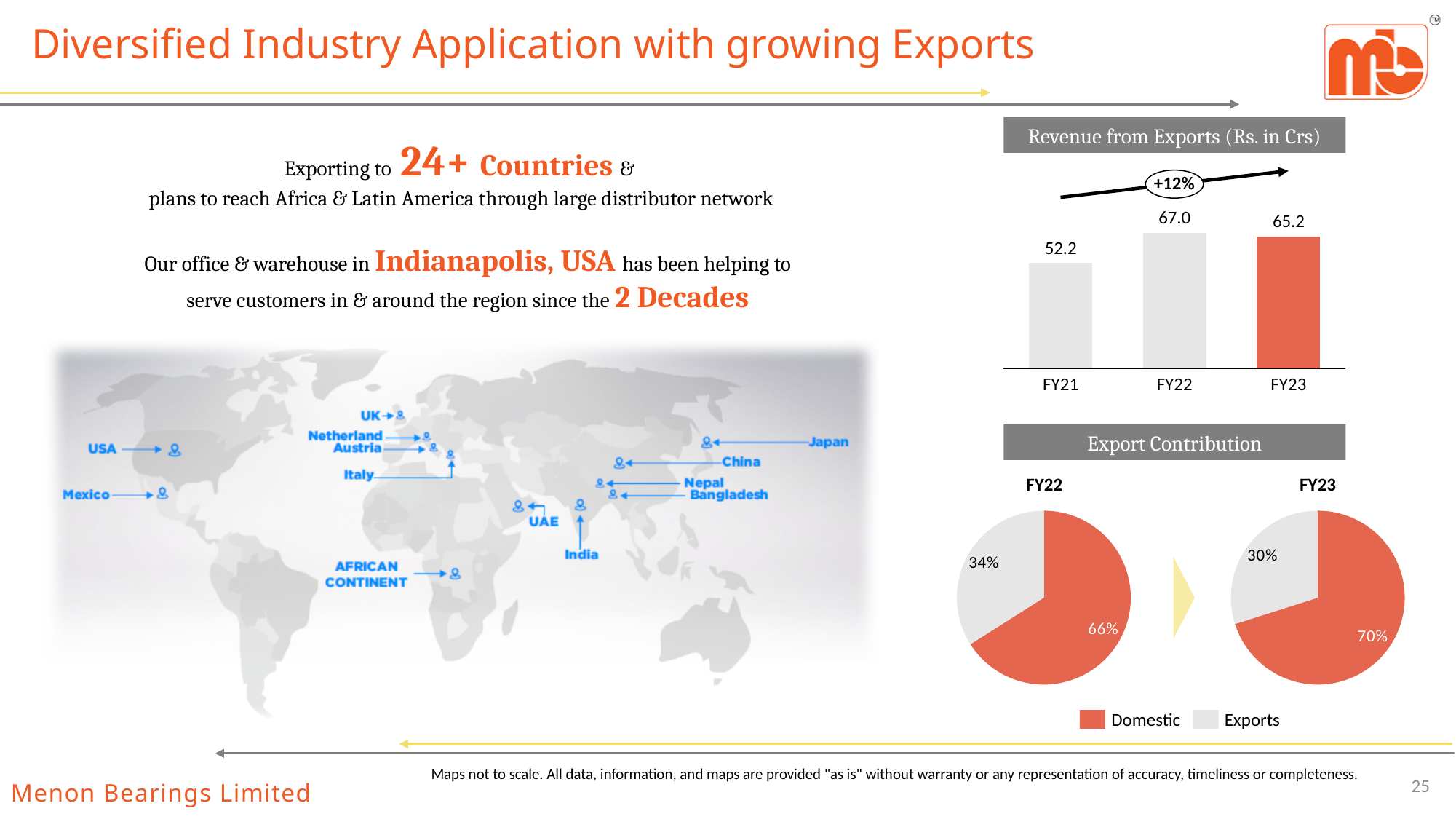
In the Revenue from Exports chart, which year has the lowest revenue? FY21 In the Export Contribution FY22 pie chart, what share is Exports? 34% How many years are shown in the Revenue from Exports chart? 3 In the Revenue from Exports chart, which is larger, the FY22 value or the FY23 value? FY22 In the Revenue from Exports chart, what is the value for FY23? 65.2 In the Export Contribution FY23 pie chart, what share is Domestic? 70% How many series does the legend of the Export Contribution charts list? 2 In the Revenue from Exports chart, which year has the highest revenue? FY22 What growth rate is annotated above the bars in the Revenue from Exports chart? +12% In the Revenue from Exports chart, what is the value for FY21? 52.2 In the Revenue from Exports chart, what is the difference between the FY22 and FY21 values? 14.8 What kind of chart is the Revenue from Exports chart? Bar chart